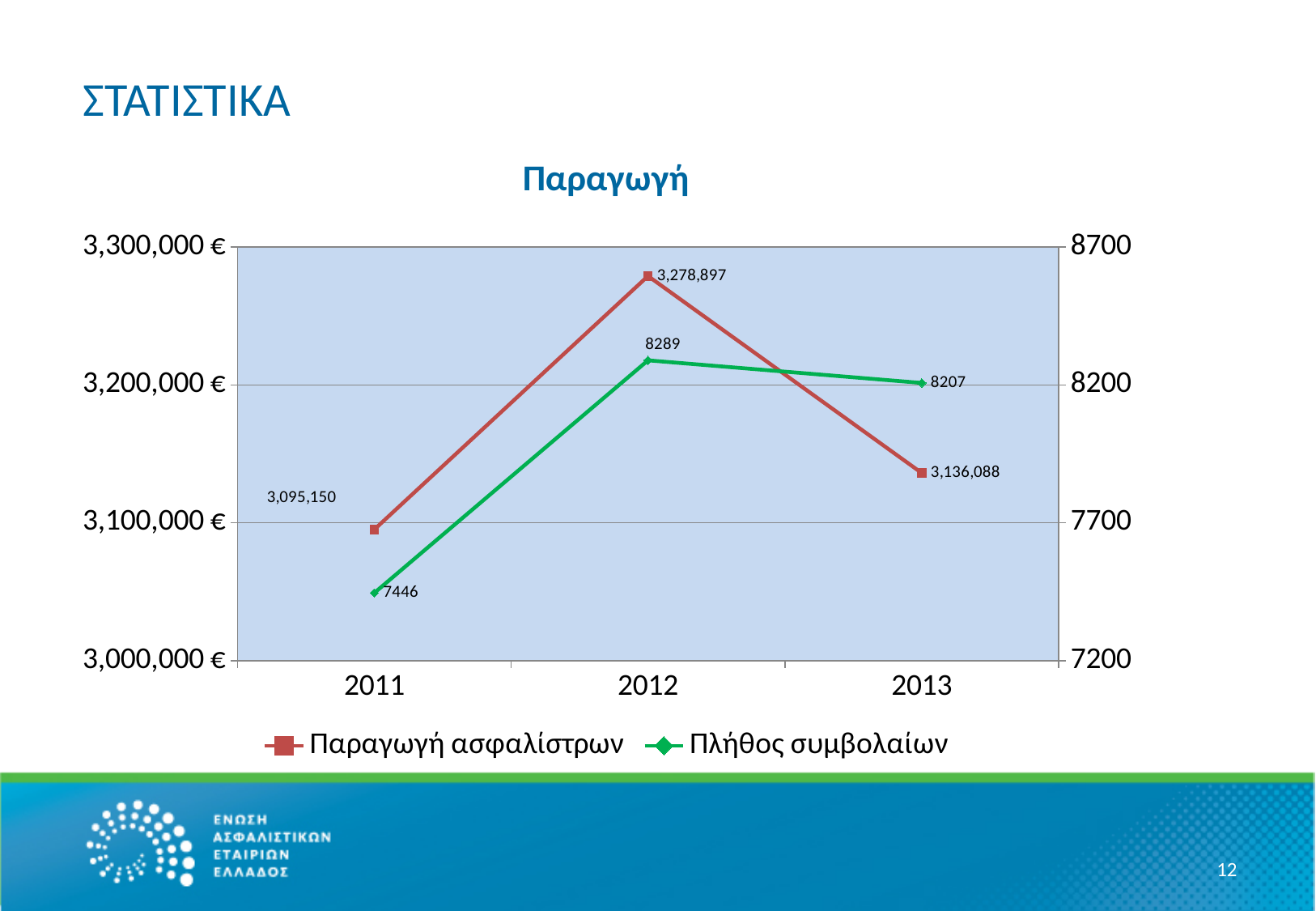
Which is larger for Παραγωγή ασφαλίστρων: the value in 2011 or the value in 2013? 2013 What is the value of Παραγωγή ασφαλίστρων in 2013? 3,136,088 In which year is Παραγωγή ασφαλίστρων highest? 2012 What is the difference between Παραγωγή ασφαλίστρων in 2012 and in 2011? 183,747 How many series does the legend list? 2 What type of chart is shown on the slide? line chart What is the difference between Πλήθος συμβολαίων in 2012 and in 2013? 82 What is the value of Πλήθος συμβολαίων in 2013? 8207 What is the value of Πλήθος συμβολαίων in 2011? 7446 How many years are shown on the x axis? 3 In which year is Πλήθος συμβολαίων lowest? 2011 What is the value of Παραγωγή ασφαλίστρων in 2012? 3,278,897